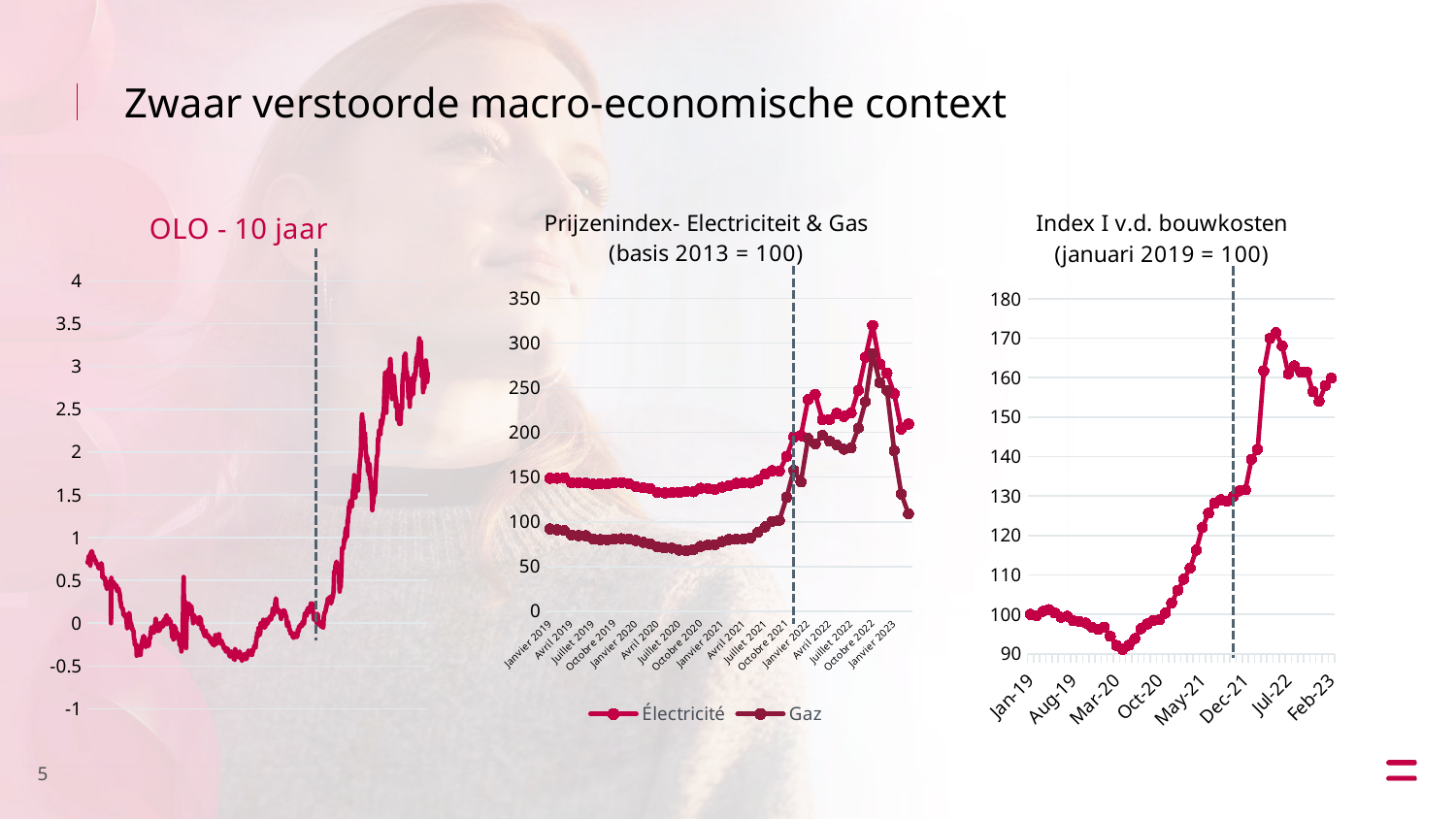
How many series does the legend of the "Prijzenindex- Electriciteit & Gas" chart list? 2 In the "Prijzenindex- Electriciteit & Gas" chart, is the Gaz value at Janvier 2023 greater or less than 150? greater What kind of chart is the "OLO - 10 jaar" chart? line chart In the "Prijzenindex- Electriciteit & Gas" chart, which series is higher at Janvier 2019, Électricité or Gaz? Électricité In the "Index I v.d. bouwkosten" chart, is the value at Mar-20 greater or less than 100? less In the "Prijzenindex- Electriciteit & Gas" chart, is the Électricité value at Janvier 2019 greater or less than 100? greater How many charts are shown on the slide? 3 In the "Prijzenindex- Electriciteit & Gas" chart, which series reaches the highest peak? Électricité What are the legend entries of the "Prijzenindex- Electriciteit & Gas" chart? Électricité and Gaz In the "Index I v.d. bouwkosten" chart, do the values rise or fall between Dec-21 and Jul-22? rise